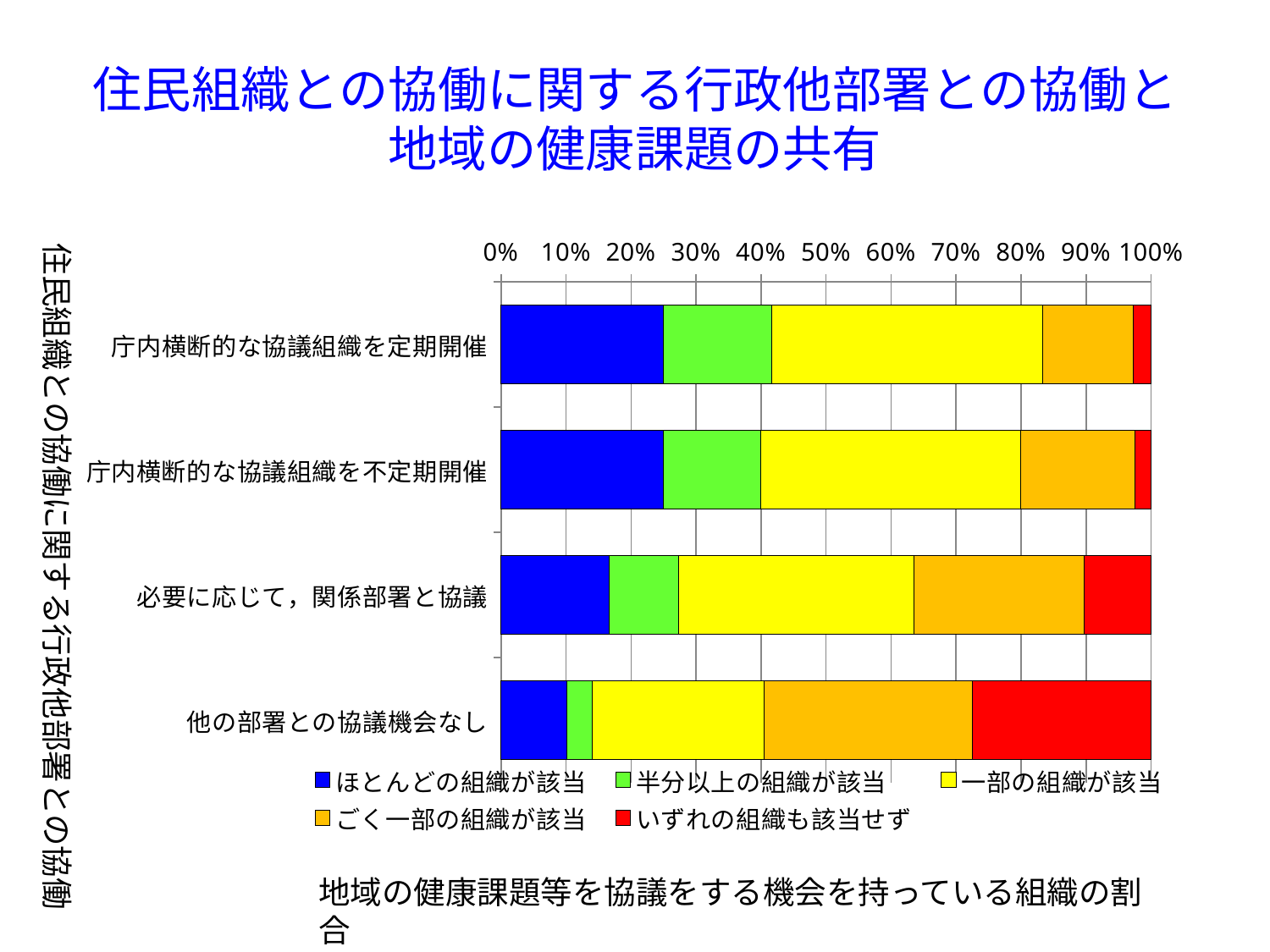
Which category has the largest share of いずれの組織も該当せず? 他の部署との協議機会なし Which series is shown in red in the legend? いずれの組織も該当せず Which category has the smallest share of ほとんどの組織が該当? 他の部署との協議機会なし How many series does the legend list? 5 Is the share of いずれの組織も該当せず for 必要に応じて，関係部署と協議 greater or less than 20%? less Which has the larger share of ほとんどの組織が該当: 必要に応じて，関係部署と協議 or 他の部署との協議機会なし? 必要に応じて，関係部署と協議 Is the share of いずれの組織も該当せず for 他の部署との協議機会なし greater or less than 20%? greater Is the share of ほとんどの組織が該当 for 他の部署との協議機会なし greater or less than 20%? less How many categories (bars) are plotted in the chart? 4 What is the highest value shown on the percentage axis? 100% What kind of chart is shown on the slide? Stacked bar chart